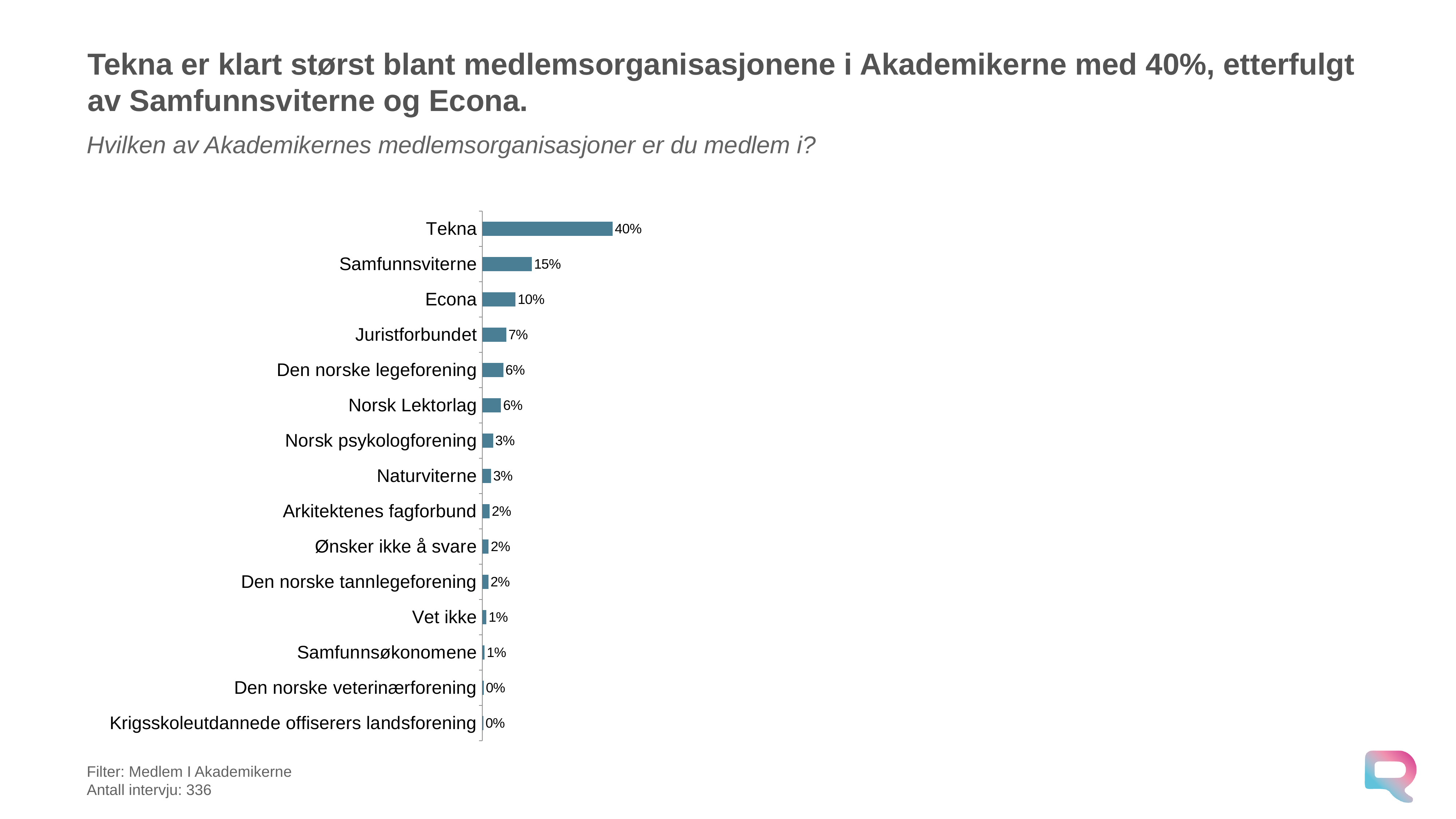
What is the value for Juristforbundet? 7% What is the difference between the values for Econa and Juristforbundet? 3 percentage points What is the difference between the values for Tekna and Samfunnsviterne? 25 percentage points Which category has the highest value? Tekna What is the value for Norsk psykologforening? 3% What kind of chart is shown on the slide? Bar chart Which is larger, the value for Econa or the value for Den norske legeforening? Econa What is the value for Samfunnsviterne? 15% What is the number of interviews (Antall intervju) stated on the slide? 336 What is the value for Tekna? 40% What is the value for Vet ikke? 1% How many categories are shown in the chart? 15